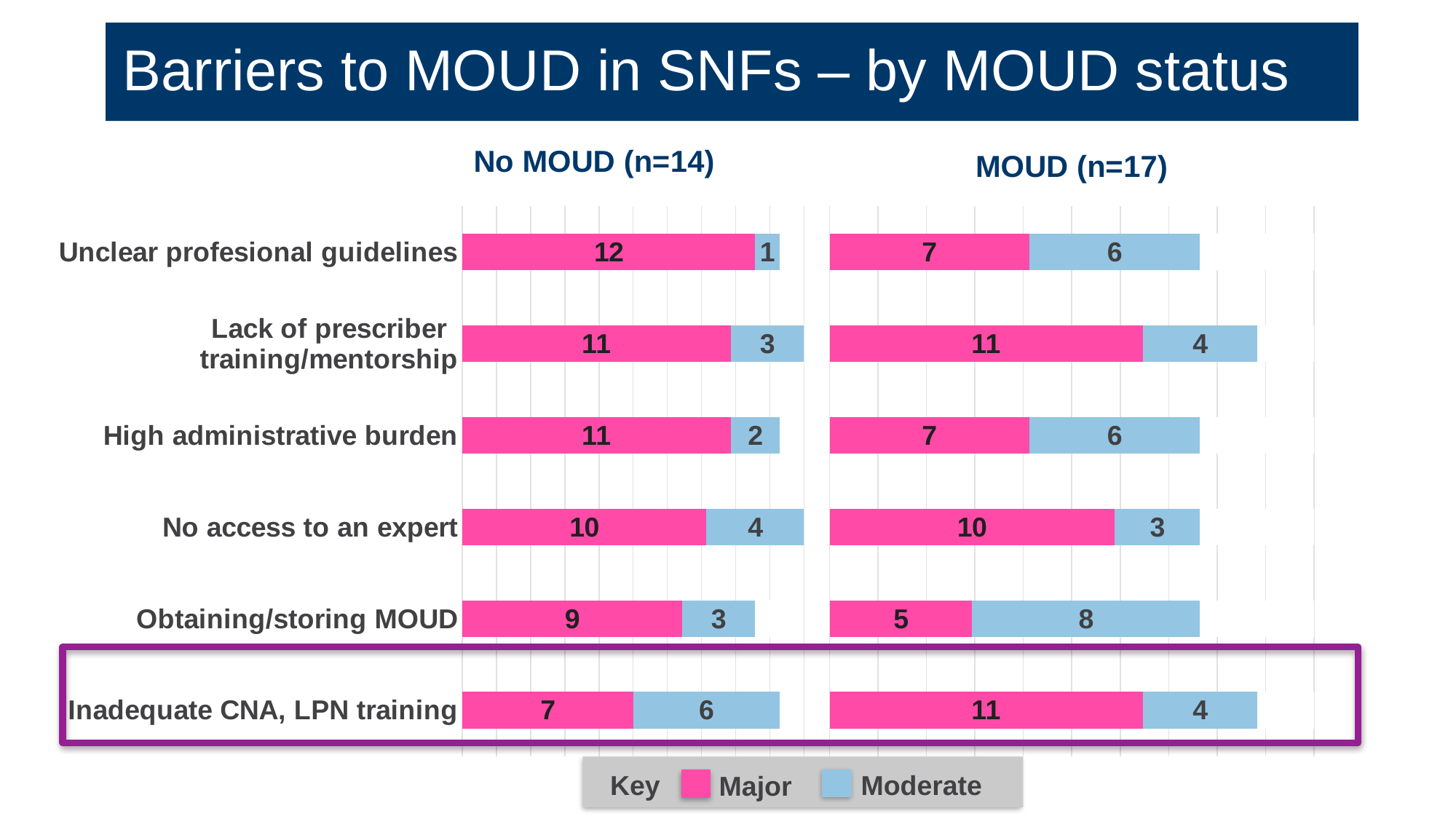
In the MOUD (n=17) chart, what is the Major value for Inadequate CNA, LPN training? 11 What kind of chart is used on this slide? Stacked bar chart In the MOUD (n=17) chart, what is the Moderate value for Obtaining/storing MOUD? 8 What is the difference between the Major value for Inadequate CNA, LPN training in the MOUD (n=17) chart and in the No MOUD (n=14) chart? 4 In the MOUD (n=17) chart, which barrier has the lowest Major value? Obtaining/storing MOUD In the No MOUD (n=14) chart, what is the total of the stacked bar for No access to an expert? 14 How many barriers (categories) are shown in each chart? 6 In the No MOUD (n=14) chart, which barrier has the highest Major value? Unclear profesional guidelines In the No MOUD (n=14) chart, what is the Major value for Unclear profesional guidelines? 12 How many series does the key list? 2 In the MOUD (n=17) chart, what is the total of the stacked bar for Lack of prescriber training/mentorship? 15 In the No MOUD (n=14) chart, which is larger for Obtaining/storing MOUD: the Major value or the Moderate value? Major